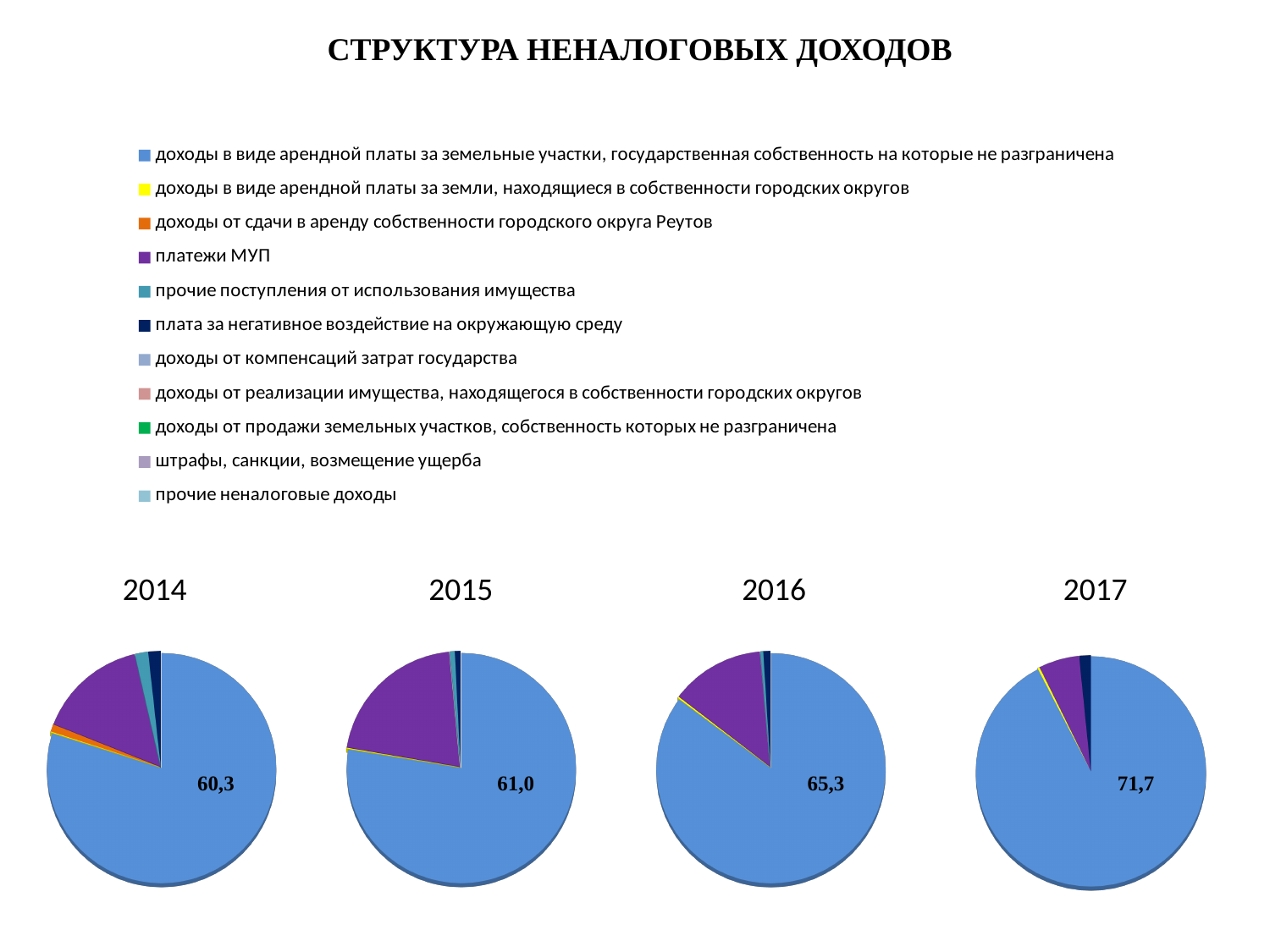
What kind of charts are shown on the slide? Pie charts In the 2015 pie chart, what value is printed on the largest slice? 61,0 In the 2016 pie chart, what value is printed on the largest slice? 65,3 Is the printed value in the 2016 pie chart larger or smaller than the printed value in the 2015 pie chart? Larger In the 2017 pie chart, what value is printed on the largest slice? 71,7 Which year's pie chart has the highest printed value on its largest slice? 2017 How many entries does the legend list? 11 In the 2014 pie chart, what value is printed on the largest slice? 60,3 Which year's pie chart has the lowest printed value on its largest slice? 2014 What is the difference between the printed value in the 2017 pie chart and the printed value in the 2014 pie chart? 11,4 In the 2017 pie chart, which legend category has the largest slice? доходы в виде арендной платы за земельные участки, государственная собственность на которые не разграничена Do the printed values on the largest slices rise or fall from 2014 to 2017? Rise